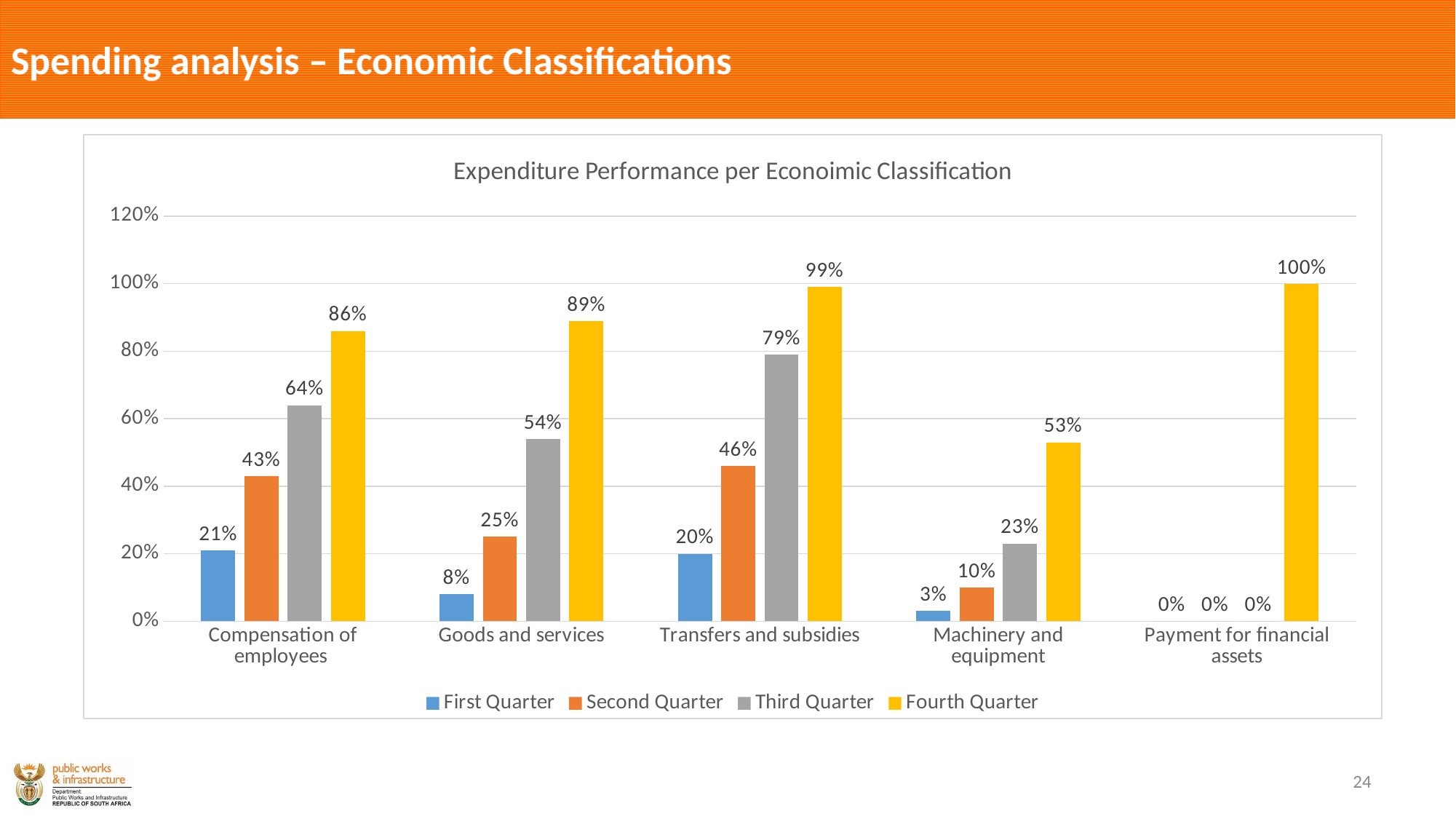
What is the Third Quarter value for Compensation of employees? 64% What is the Fourth Quarter value for Transfers and subsidies? 99% Which is larger: the Second Quarter value for Compensation of employees or the Second Quarter value for Transfers and subsidies? Transfers and subsidies Which category has the lowest Third Quarter value? Payment for financial assets What is the title of the chart? Expenditure Performance per Econoimic Classification What is the First Quarter value for Machinery and equipment? 3% What is the Second Quarter value for Goods and services? 25% How many categories are shown on the x axis? 5 What is the difference between the Fourth Quarter and Third Quarter values for Goods and services? 35% What kind of chart is shown on the slide? Bar chart Which category has the highest Fourth Quarter value? Payment for financial assets How many series does the legend list? 4